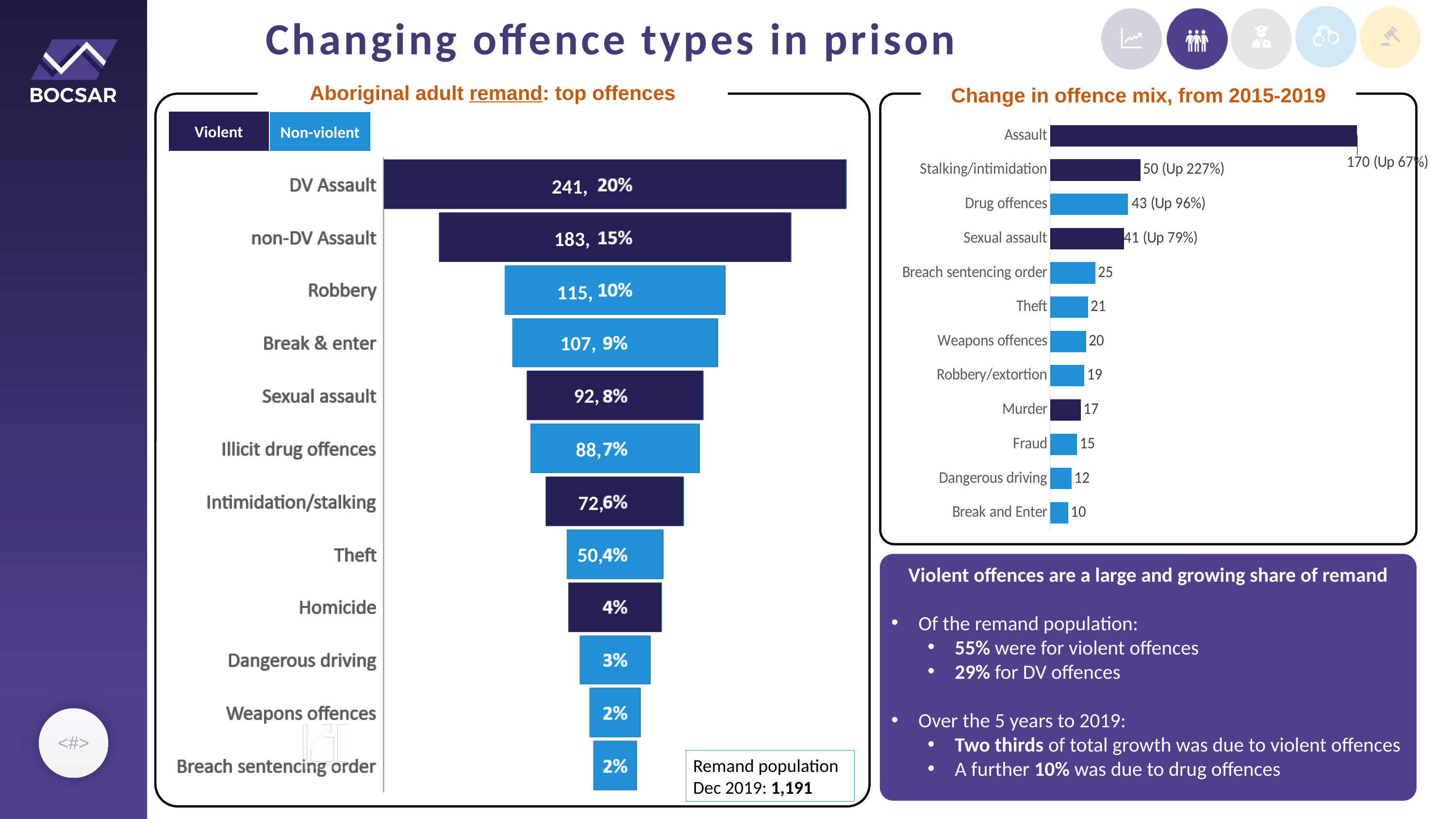
In the 'Aboriginal adult remand: top offences' chart, how many offence categories are shown? 12 In the 'Aboriginal adult remand: top offences' chart, what percentage share does Robbery have? 10% In the 'Aboriginal adult remand: top offences' chart, how many people are on remand for DV Assault? 241 In the 'Change in offence mix, from 2015-2019' chart, what is the value for Stalking/intimidation? 50 (Up 227%) In the 'Change in offence mix, from 2015-2019' chart, which offence has the lowest value? Break and Enter In the 'Aboriginal adult remand: top offences' chart, what is the difference between the counts for DV Assault and non-DV Assault? 58 In the 'Aboriginal adult remand: top offences' chart, which offence has the highest value? DV Assault In the 'Aboriginal adult remand: top offences' chart, how many series does the legend list? 2 In the 'Change in offence mix, from 2015-2019' chart, which is larger: Drug offences or Sexual assault? Drug offences What kind of chart is 'Change in offence mix, from 2015-2019'? Bar chart In the 'Aboriginal adult remand: top offences' chart, what are the two legend entries? Violent, Non-violent In the 'Change in offence mix, from 2015-2019' chart, what is the difference between the values for Assault and Stalking/intimidation? 120